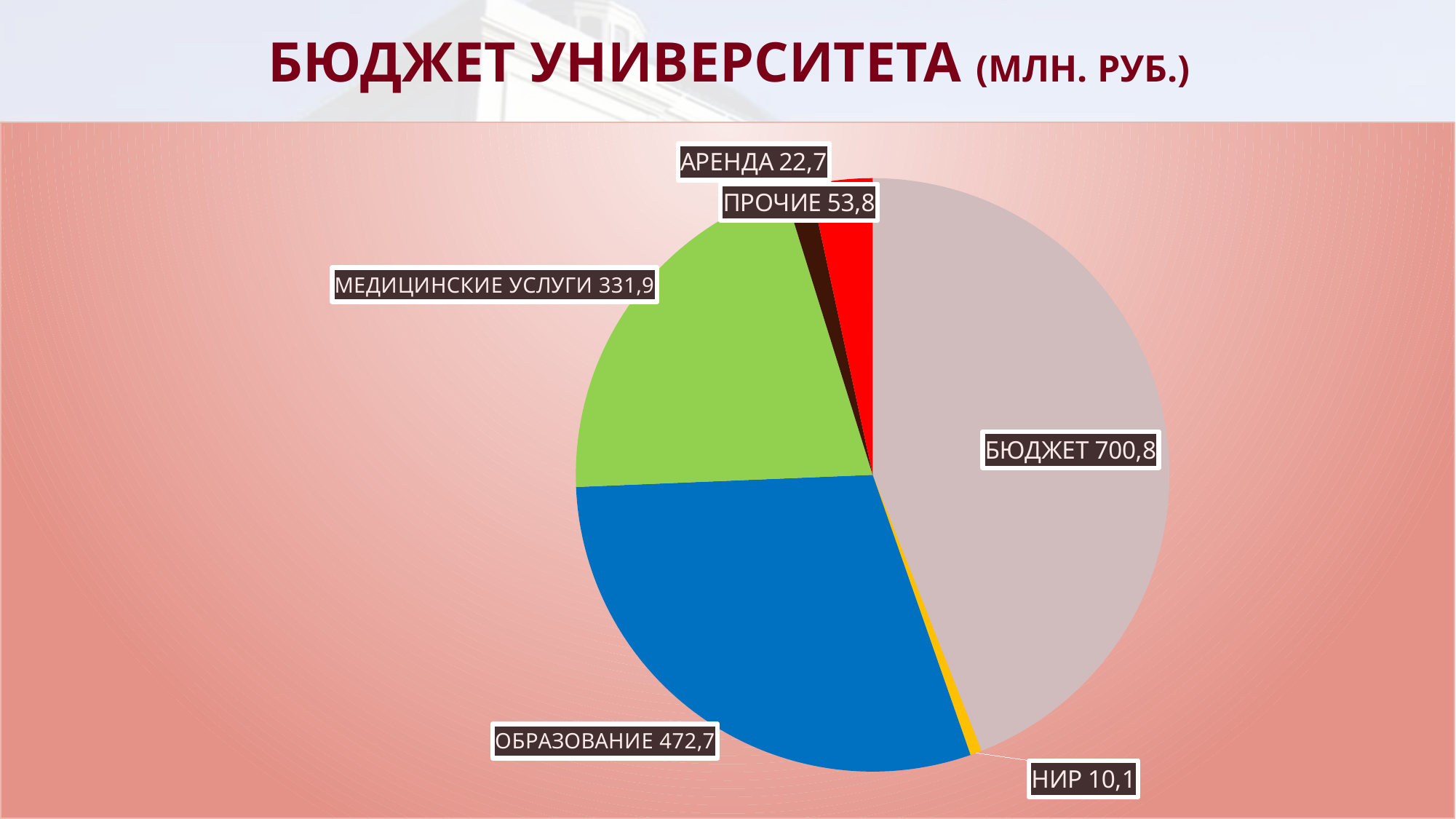
What is the value for НИР? 10,1 What is the difference between the values for БЮДЖЕТ and ОБРАЗОВАНИЕ? 228,1 What is the value for МЕДИЦИНСКИЕ УСЛУГИ? 331,9 Which category has the largest slice of the pie? БЮДЖЕТ What is the title of the chart? БЮДЖЕТ УНИВЕРСИТЕТА (МЛН. РУБ.) Which is larger, the value for МЕДИЦИНСКИЕ УСЛУГИ or the value for ОБРАЗОВАНИЕ? ОБРАЗОВАНИЕ What is the value for БЮДЖЕТ? 700,8 Which category has the smallest slice of the pie? НИР What is the value for ОБРАЗОВАНИЕ? 472,7 What kind of chart is shown on the slide? Pie chart How many slices does the pie chart have? 6 What is the difference between the values for ПРОЧИЕ and АРЕНДА? 31,1